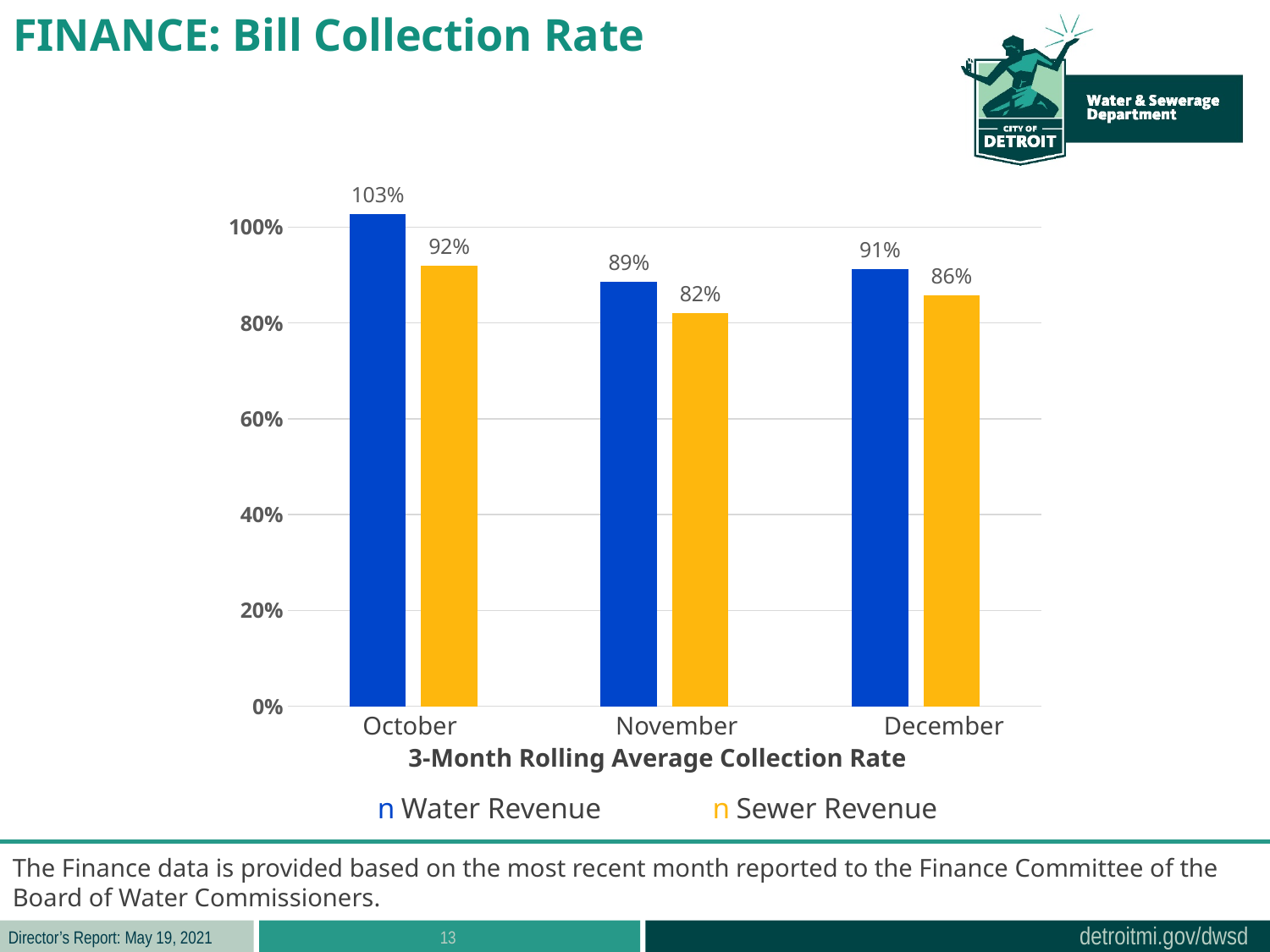
What is the Water Revenue collection rate for December? 91% How many series does the legend list? 2 What kind of chart is shown on the slide? Bar chart What is the Water Revenue collection rate for October? 103% Which month has the lowest Sewer Revenue collection rate? November How many months are shown on the x axis? 3 What is the Sewer Revenue collection rate for October? 92% What is the difference between the Water Revenue and Sewer Revenue collection rates in October? 11% What is the x-axis title of the chart? 3-Month Rolling Average Collection Rate Which month has the highest Water Revenue collection rate? October What is the Sewer Revenue collection rate for November? 82% Which is larger in December, the Water Revenue or the Sewer Revenue collection rate? Water Revenue